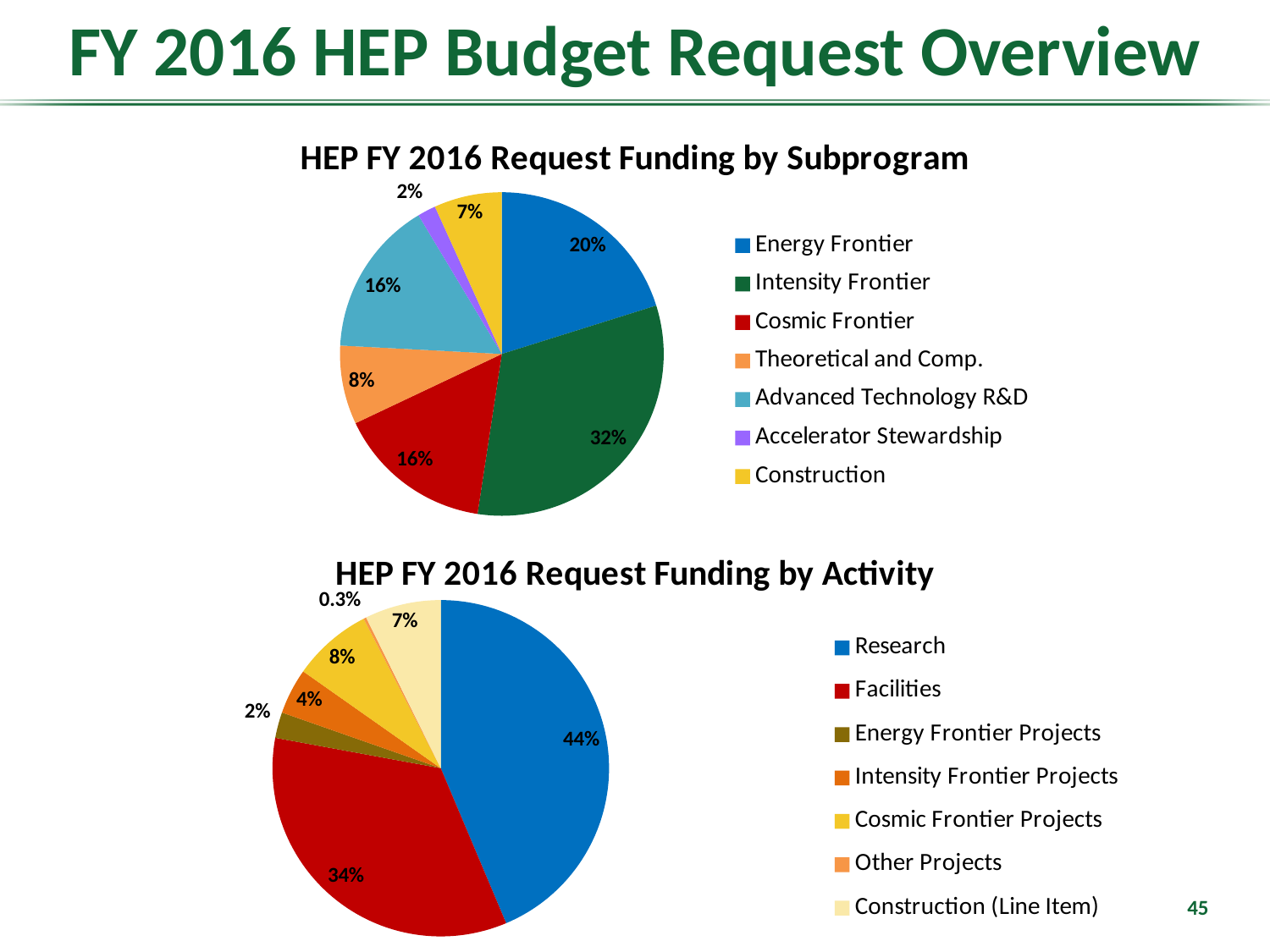
In the 'HEP FY 2016 Request Funding by Subprogram' chart, how many subprograms are listed in the legend? 7 In the 'HEP FY 2016 Request Funding by Subprogram' chart, what share does Theoretical and Comp. have? 8% In the 'HEP FY 2016 Request Funding by Subprogram' chart, which subprogram has the smallest share? Accelerator Stewardship In the 'HEP FY 2016 Request Funding by Subprogram' chart, what is the difference between the Intensity Frontier share and the Energy Frontier share? 12% In the 'HEP FY 2016 Request Funding by Subprogram' chart, which subprogram has the largest share? Intensity Frontier In the 'HEP FY 2016 Request Funding by Activity' chart, what colour is the Facilities slice? Red In the 'HEP FY 2016 Request Funding by Activity' chart, which is larger, Cosmic Frontier Projects or Intensity Frontier Projects? Cosmic Frontier Projects In the 'HEP FY 2016 Request Funding by Activity' chart, what share does Research have? 44% In the 'HEP FY 2016 Request Funding by Subprogram' chart, what share does Intensity Frontier have? 32% In the 'HEP FY 2016 Request Funding by Activity' chart, which activity has the largest share? Research In the 'HEP FY 2016 Request Funding by Activity' chart, what share does Other Projects have? 0.3% What type of chart is 'HEP FY 2016 Request Funding by Activity'? Pie chart